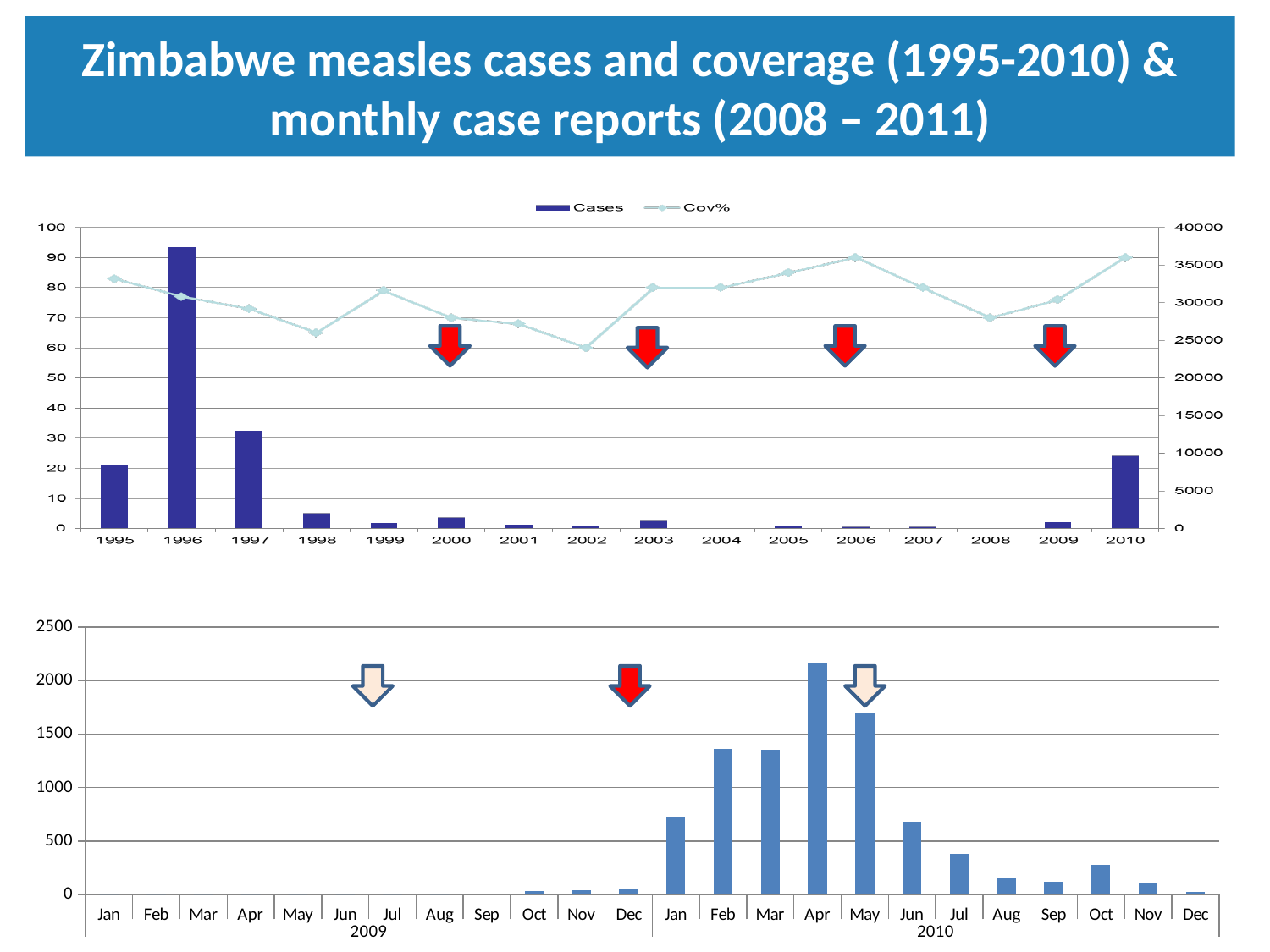
In the bottom chart, is the value for Apr 2010 greater or less than 2000? greater In the top chart, which year has the highest Cases bar? 1996 In the bottom chart, which month has the larger value, May 2010 or Jun 2010? May 2010 In the top chart, which year has the lowest Cov% value? 2002 In the top chart, which year has the larger Cases bar, 1995 or 1997? 1997 What kind of chart is the bottom chart? bar chart In the top chart, which year has the higher Cov% value, 1995 or 1998? 1995 In the bottom chart, is the value for Jul 2010 greater or less than 500? less How many series does the legend of the top chart list? 2 What are the two series named in the legend of the top chart? Cases and Cov% In the bottom chart, which month has the highest bar? Apr 2010 How many years are shown on the x axis of the top chart? 16